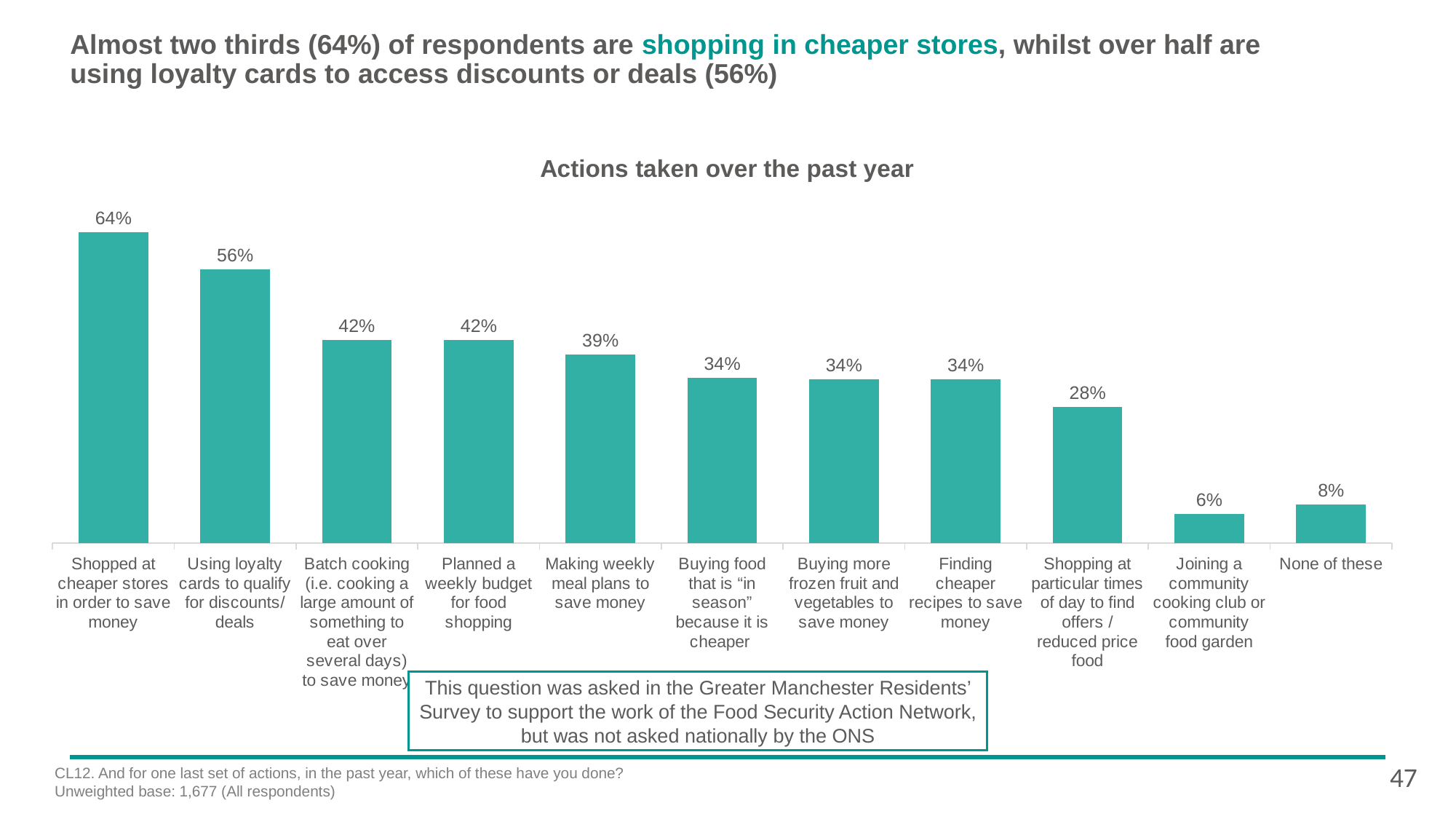
What is the value for 'Using loyalty cards to qualify for discounts/deals'? 56% What percentage of respondents reported making weekly meal plans to save money? 39% Which is larger: the value for 'None of these' or the value for 'Joining a community cooking club or community food garden'? None of these How many categories share the value of 34%? 3 What is the difference between the value for 'Shopped at cheaper stores in order to save money' and 'Using loyalty cards to qualify for discounts/deals'? 8% How many categories are shown in the chart? 11 What type of chart is shown on the slide? Bar chart Which action has the highest percentage of respondents? Shopped at cheaper stores in order to save money Which category has the lowest value in the chart? Joining a community cooking club or community food garden What is the value for 'Shopping at particular times of day to find offers / reduced price food'? 28% What is the title of the chart? Actions taken over the past year What percentage of respondents shopped at cheaper stores in order to save money? 64%